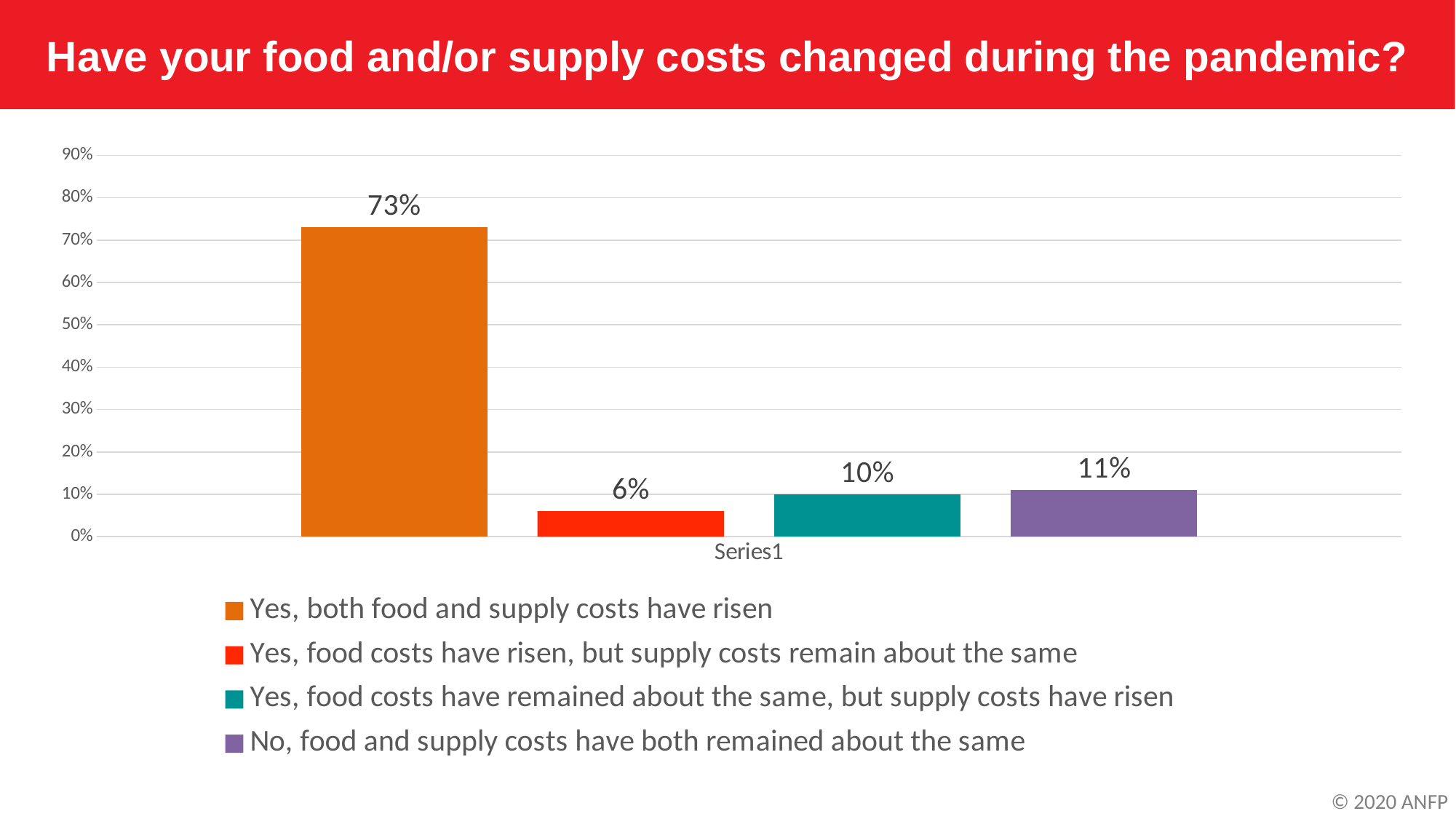
What type of chart is shown on the slide? Bar chart How many response categories are shown in the chart? 4 What colour is the bar for 'Yes, food costs have remained about the same, but supply costs have risen'? Teal Which response has the highest percentage? Yes, both food and supply costs have risen What percentage of respondents said food costs have remained about the same but supply costs have risen? 10% What percentage of respondents said both food and supply costs have risen? 73% Which is larger: the percentage for 'Yes, food costs have remained about the same, but supply costs have risen' or for 'No, food and supply costs have both remained about the same'? No, food and supply costs have both remained about the same What percentage of respondents said food and supply costs have both remained about the same? 11% What is the difference in percentage points between 'Yes, both food and supply costs have risen' and 'No, food and supply costs have both remained about the same'? 62 Which response has the lowest percentage? Yes, food costs have risen, but supply costs remain about the same What percentage of respondents said food costs have risen but supply costs remain about the same? 6% Is the value for 'Yes, both food and supply costs have risen' greater or less than 50%? greater